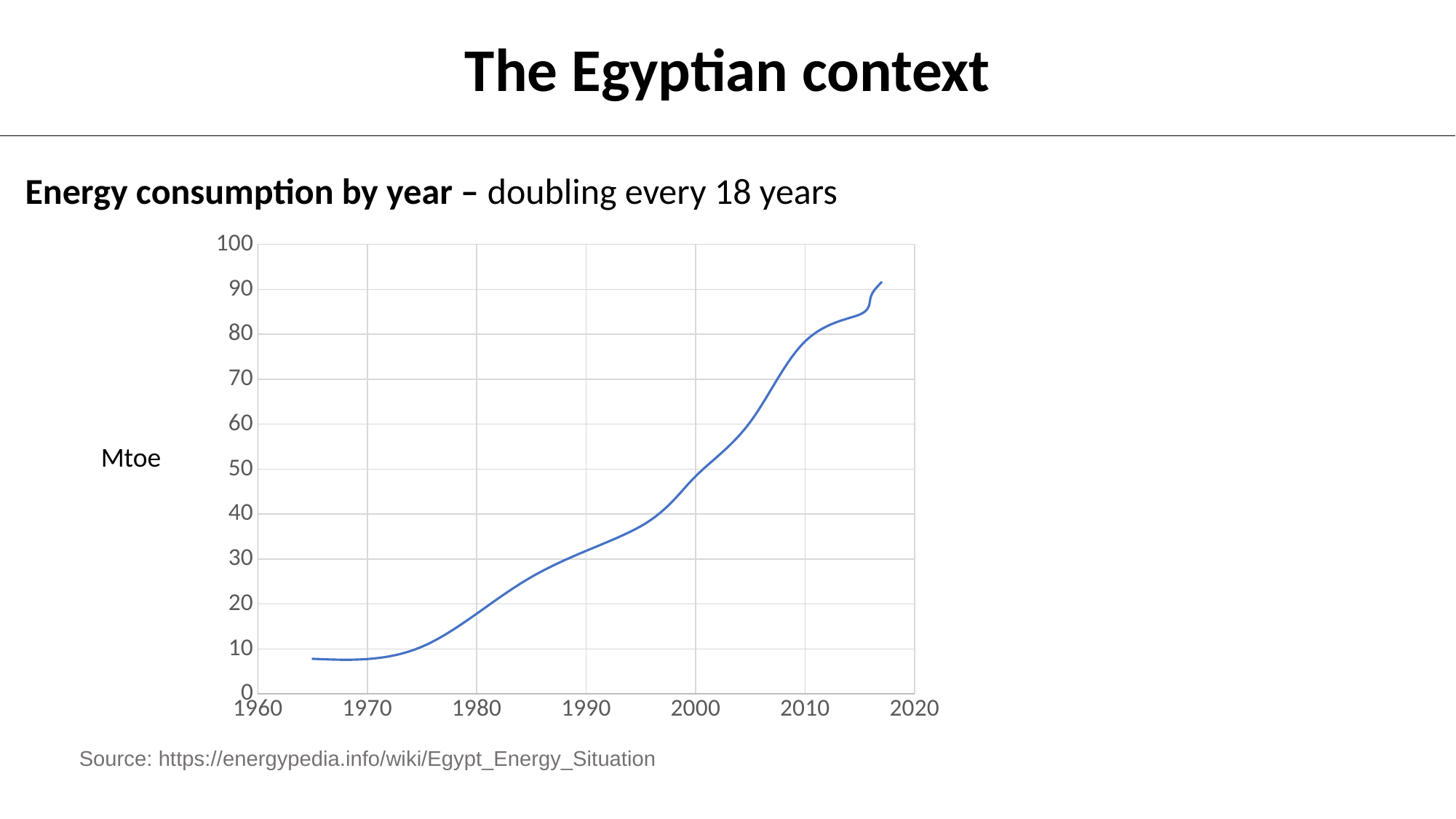
Does energy consumption rise or fall over the years shown in the chart? rise What kind of chart is shown on the slide? line chart Is the energy consumption value for 1970 greater or less than 10? less Is the energy consumption value at the end of the line (around 2017) greater or less than 80? greater What unit is shown on the y axis of the chart? Mtoe Is the energy consumption value for 2010 greater or less than 70? greater What is the highest value shown on the y axis of the chart? 100 Which year has the higher energy consumption, 1980 or 2000? 2000